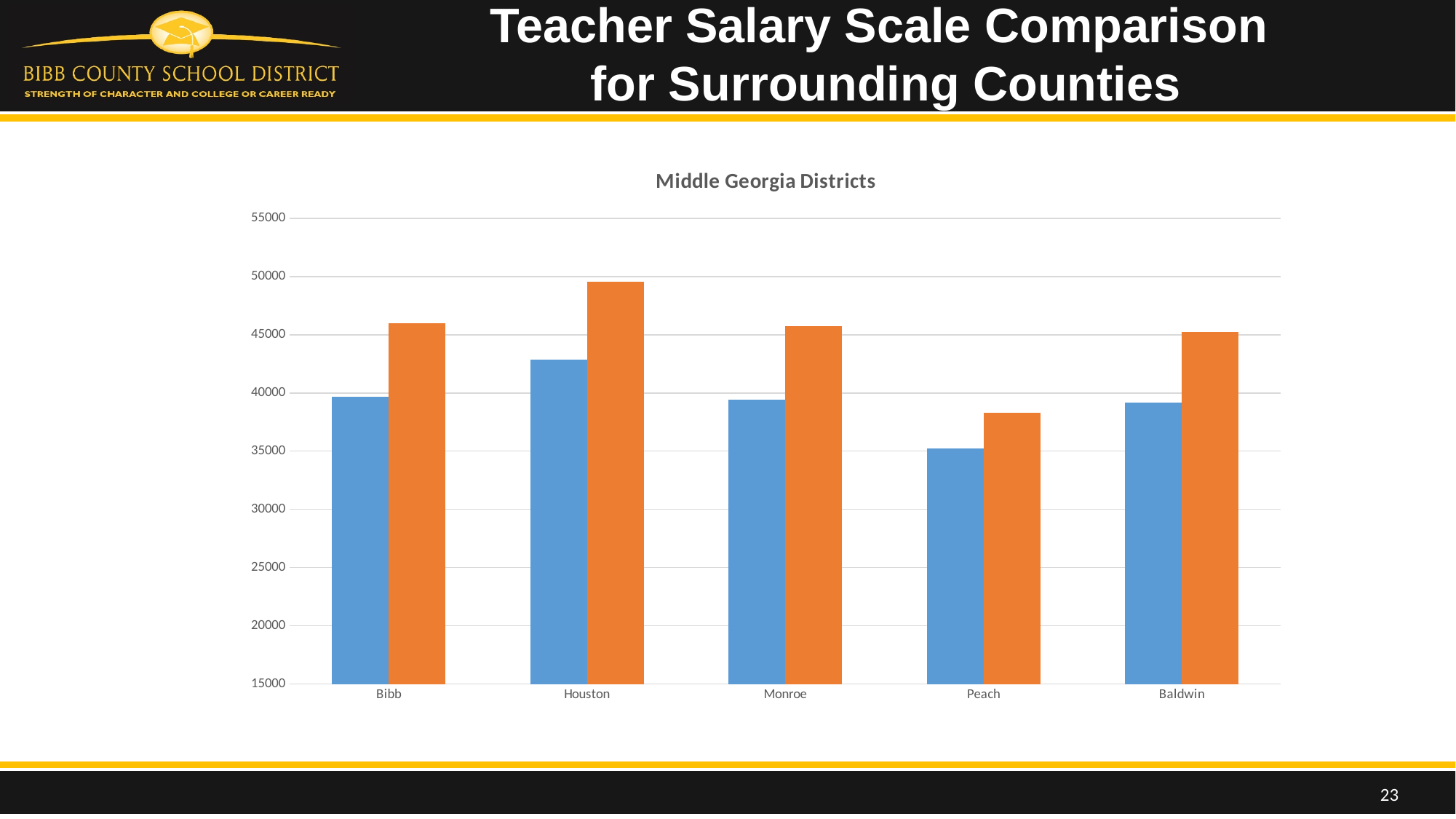
Is the orange bar for Peach greater or less than 40000? less How many districts are shown on the x axis of the chart? 5 How many bars are plotted for each district? 2 Which district has the shortest orange bar? Peach Which is larger, the blue bar for Houston or the blue bar for Peach? Houston What is the title of the chart? Middle Georgia Districts Is the blue bar for Houston greater or less than 40000? greater Is the blue bar for Peach greater or less than 40000? less Which district has the shortest blue bar? Peach Which district has the tallest orange bar? Houston What kind of chart is shown on the slide? bar chart